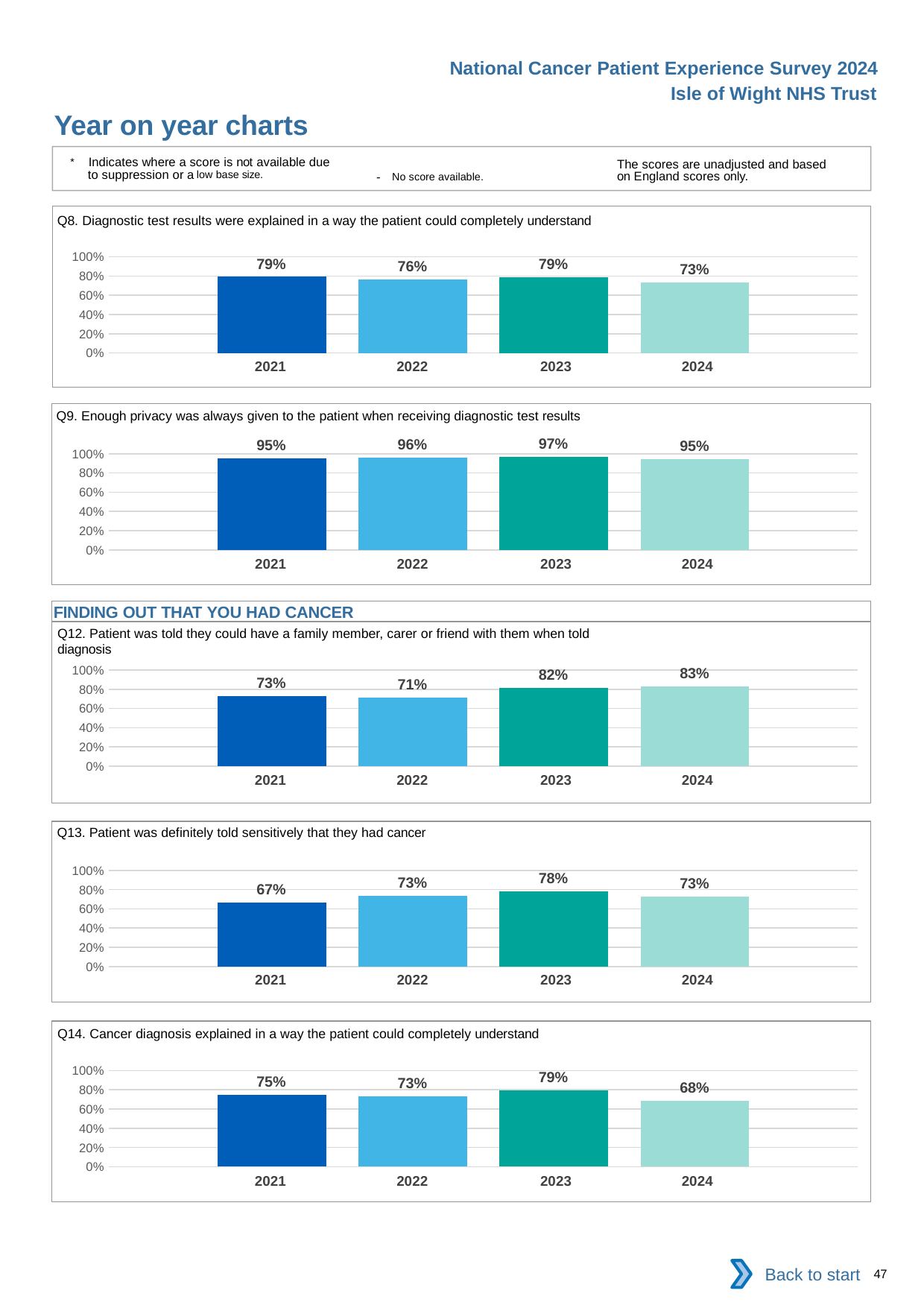
In the Q9 chart (Enough privacy was always given to the patient when receiving diagnostic test results), which year has the highest value? 2023 In the Q13 chart, what is the difference between the 2023 and 2021 values? 11 percentage points In the Q12 chart, which is larger, the value for 2021 or the value for 2023? 2023 In the Q8 chart (Diagnostic test results were explained in a way the patient could completely understand), what is the value for 2024? 73% In the Q9 chart, is the value for 2022 greater or less than 80%? greater What is the section heading shown above the Q12 chart? FINDING OUT THAT YOU HAD CANCER What type of chart is used for Q13 (Patient was definitely told sensitively that they had cancer)? Bar chart In the Q14 chart (Cancer diagnosis explained in a way the patient could completely understand), what is the difference between the 2023 and 2024 values? 11 percentage points In the Q8 chart, how many years are plotted? 4 In the Q13 chart (Patient was definitely told sensitively that they had cancer), which year has the lowest value? 2021 In the Q12 chart (Patient was told they could have a family member, carer or friend with them when told diagnosis), what is the value for 2022? 71% In the Q14 chart, which year has the highest value? 2023